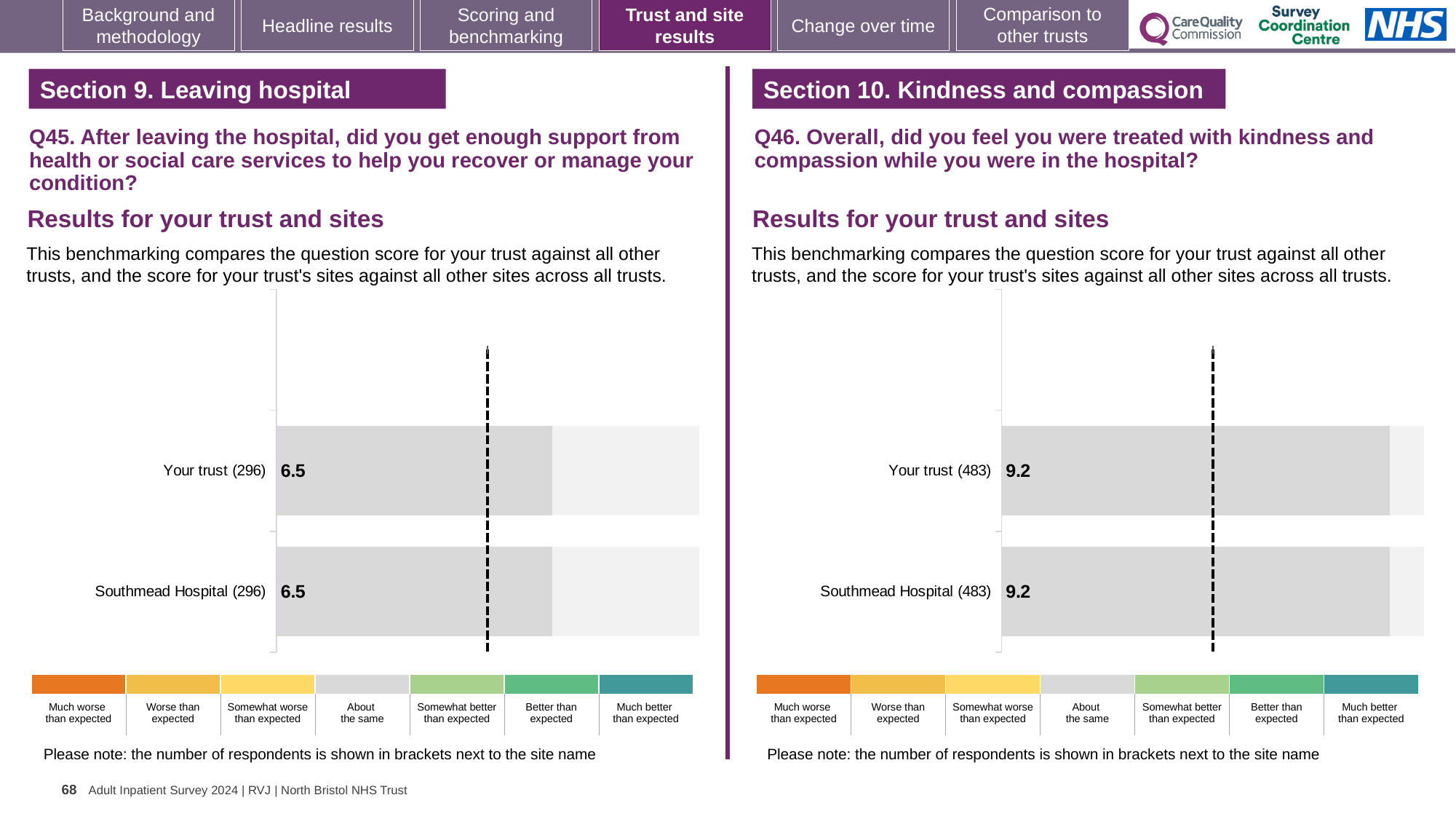
In the Q45 chart on the left, how many respondents are shown in brackets next to Your trust? 296 In the Q46 chart on the right, what is the score for Southmead Hospital? 9.2 In the Q45 chart on the left, what is the difference between the scores for Your trust and Southmead Hospital? 0 What kind of chart is used for the Q45 results on the left? Bar chart In the Q46 chart on the right, what is the score for Your trust? 9.2 How many bars are plotted in the Q46 chart on the right? 2 In the Q46 chart on the right, is the score for Your trust larger than, smaller than, or the same as the score for Southmead Hospital? the same In the Q46 chart on the right, how many respondents are shown in brackets next to Southmead Hospital? 483 In the Q45 chart on the left, what is the score for Southmead Hospital? 6.5 In the Q45 chart on the left, what is the score for Your trust? 6.5 How many bars are plotted in the Q45 chart on the left? 2